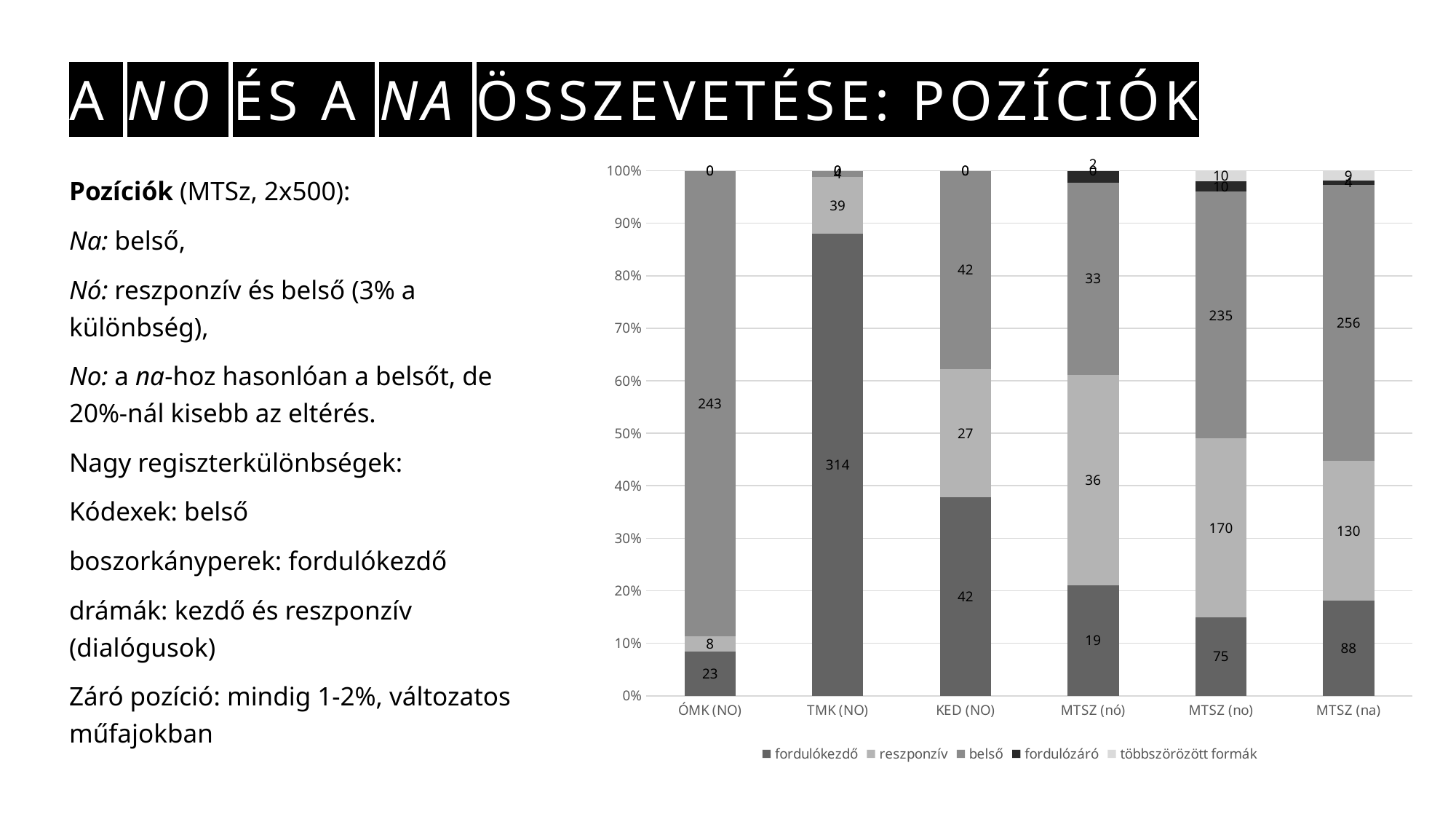
What is the reszponzív value for MTSZ (no)? 170 Is the fordulókezdő share of the TMK (NO) bar greater or less than 80%? greater How many categories are shown on the x axis of the chart? 6 What kind of chart is shown on the slide? stacked bar chart What is the difference between the belső values for MTSZ (na) and MTSZ (no)? 21 What is the total of all segments in the MTSZ (no) bar? 500 Which has the larger fordulókezdő value, MTSZ (na) or MTSZ (no)? MTSZ (na) How many series does the chart's legend list? 5 What is the belső value for ÓMK (NO)? 243 Which category has the highest fordulókezdő value? TMK (NO) What is the belső value for MTSZ (na)? 256 What is the fordulókezdő value for TMK (NO)? 314